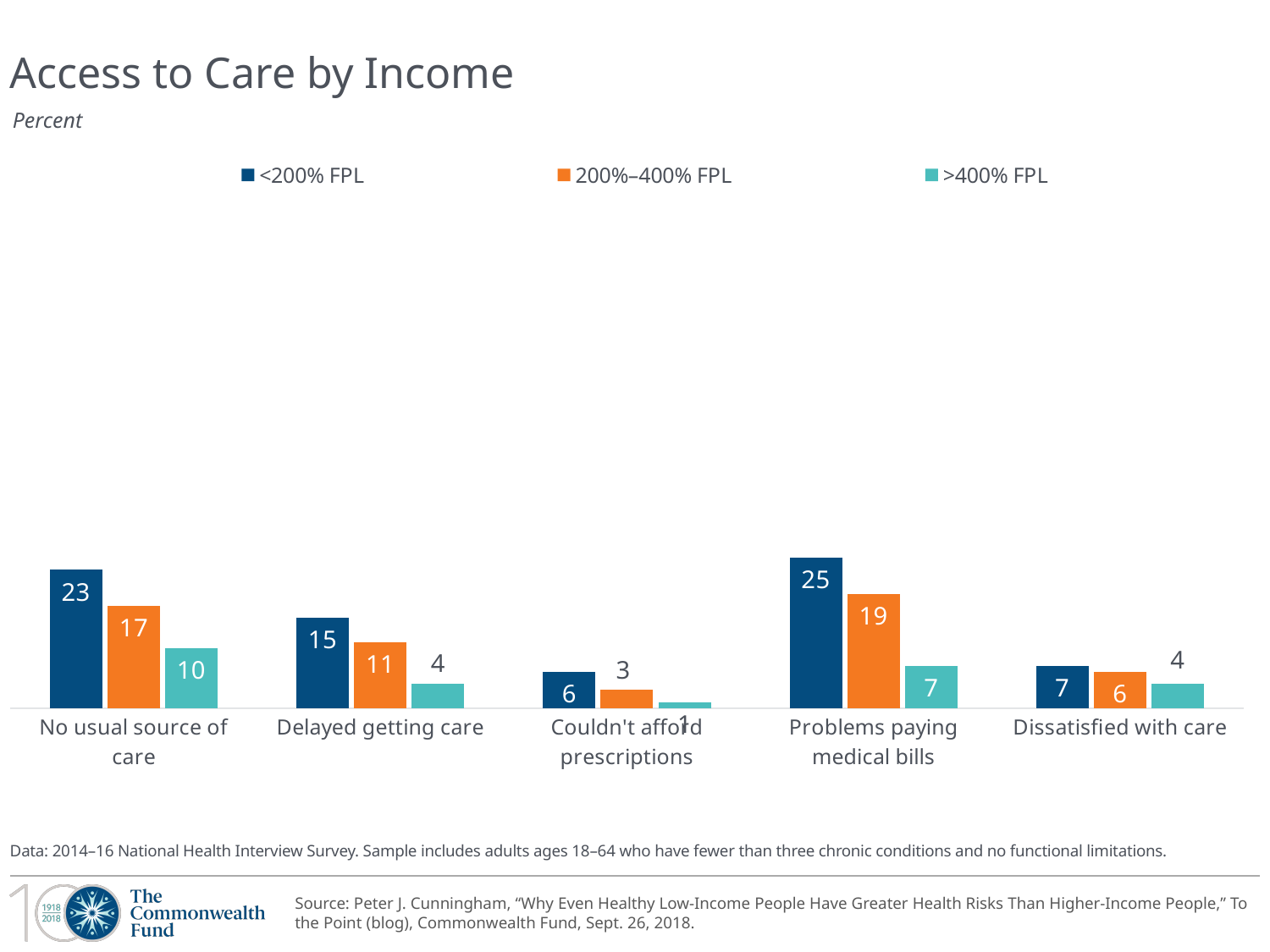
What is the difference between the <200% FPL and >400% FPL values for "Problems paying medical bills"? 18 What is the difference between the <200% FPL and 200%–400% FPL values for "Dissatisfied with care"? 1 How many series does the legend list? 3 What is the value for >400% FPL in the "Delayed getting care" category? 4 Which is larger: the 200%–400% FPL value for "No usual source of care" or the 200%–400% FPL value for "Delayed getting care"? No usual source of care What is the title of the chart? Access to Care by Income What kind of chart is shown on the slide? Bar chart Which category has the highest value for the <200% FPL series? Problems paying medical bills How many categories are shown on the x axis? 5 What is the value for 200%–400% FPL in the "Problems paying medical bills" category? 19 Which category has the lowest value for the 200%–400% FPL series? Couldn't afford prescriptions What is the value for <200% FPL in the "No usual source of care" category? 23